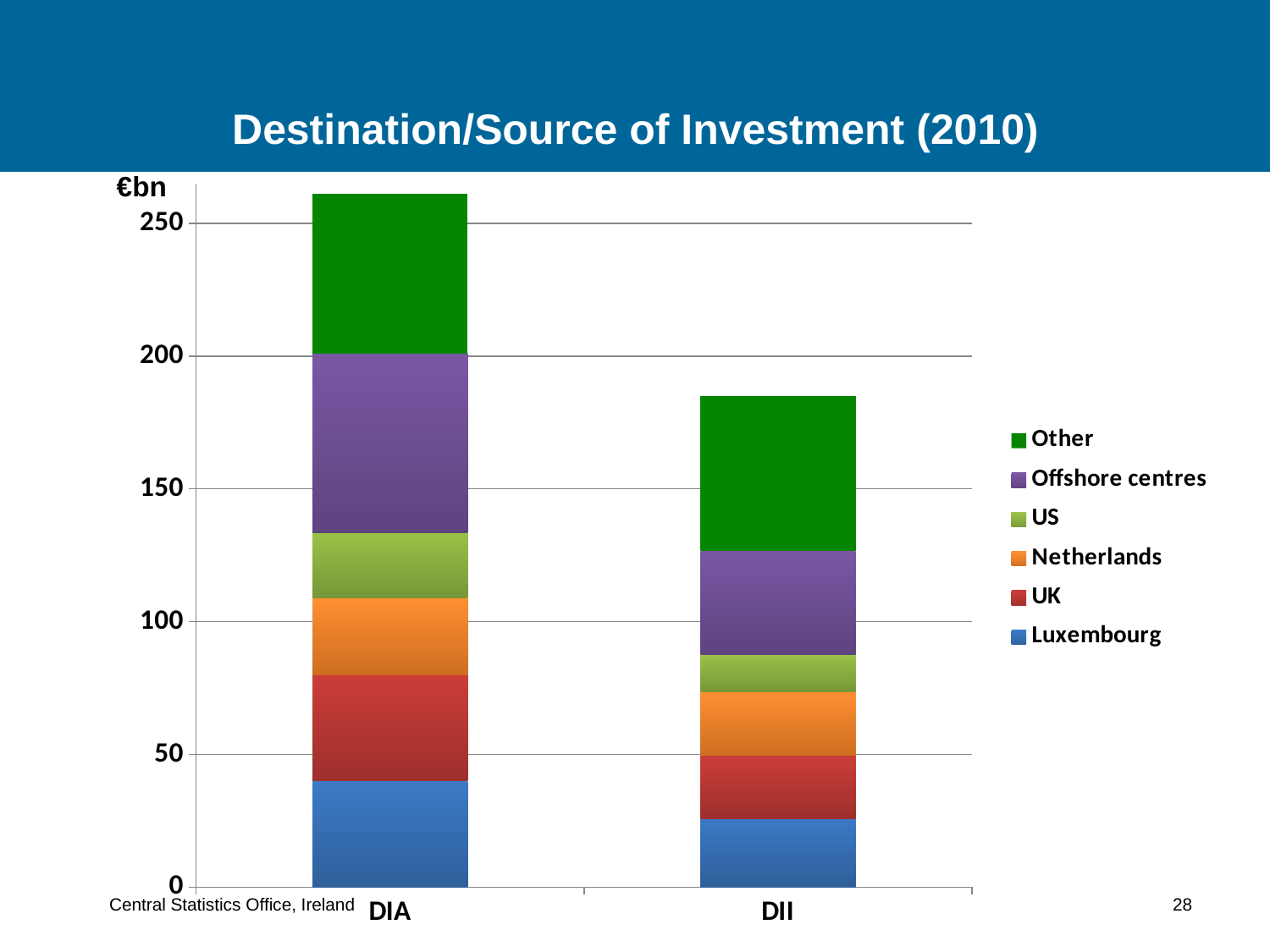
What is the title of the chart? Destination/Source of Investment (2010) Which category has the larger Luxembourg segment, DIA or DII? DIA Which category has the larger Offshore centres segment, DIA or DII? DIA Is the total of the DIA stacked bar greater or less than 250? greater What unit is shown at the top of the vertical axis? €bn How many categories are plotted along the x axis? 2 What kind of chart is shown on the slide? stacked bar chart Is the Luxembourg value for DIA greater or less than 50? less Is the total of the DII stacked bar greater or less than 200? less How many series does the legend list? 6 Which category has the taller stacked bar, DIA or DII? DIA